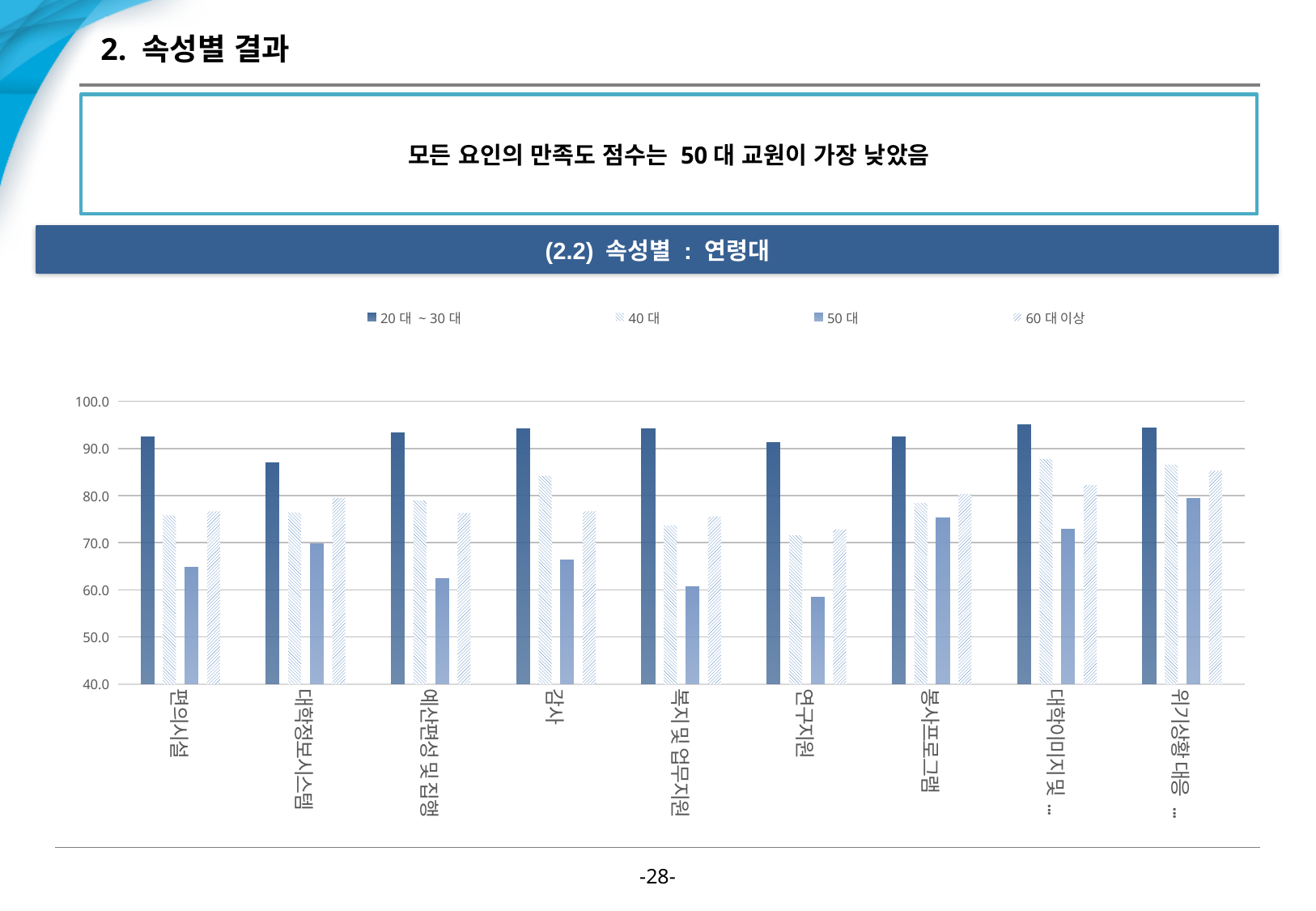
Is the value for 50대 in the 봉사프로그램 category greater or less than 70? greater For the 50대 series, which category has the highest value? 위기상황 대응 … Is the value for 50대 in the 편의시설 category greater or less than 60? greater How many series does the legend list? 4 In the 편의시설 category, which is larger: the value for 20대 ~ 30대 or the value for 50대? 20대 ~ 30대 Is the value for 50대 in the 연구지원 category greater or less than 60? less In the 감사 category, which is larger: the value for 40대 or the value for 50대? 40대 How many categories are shown on the x axis? 9 What kind of chart is shown on the slide? bar chart For the 20대 ~ 30대 series, which category has the lowest value? 대학정보시스템 Which series is listed first in the legend? 20대 ~ 30대